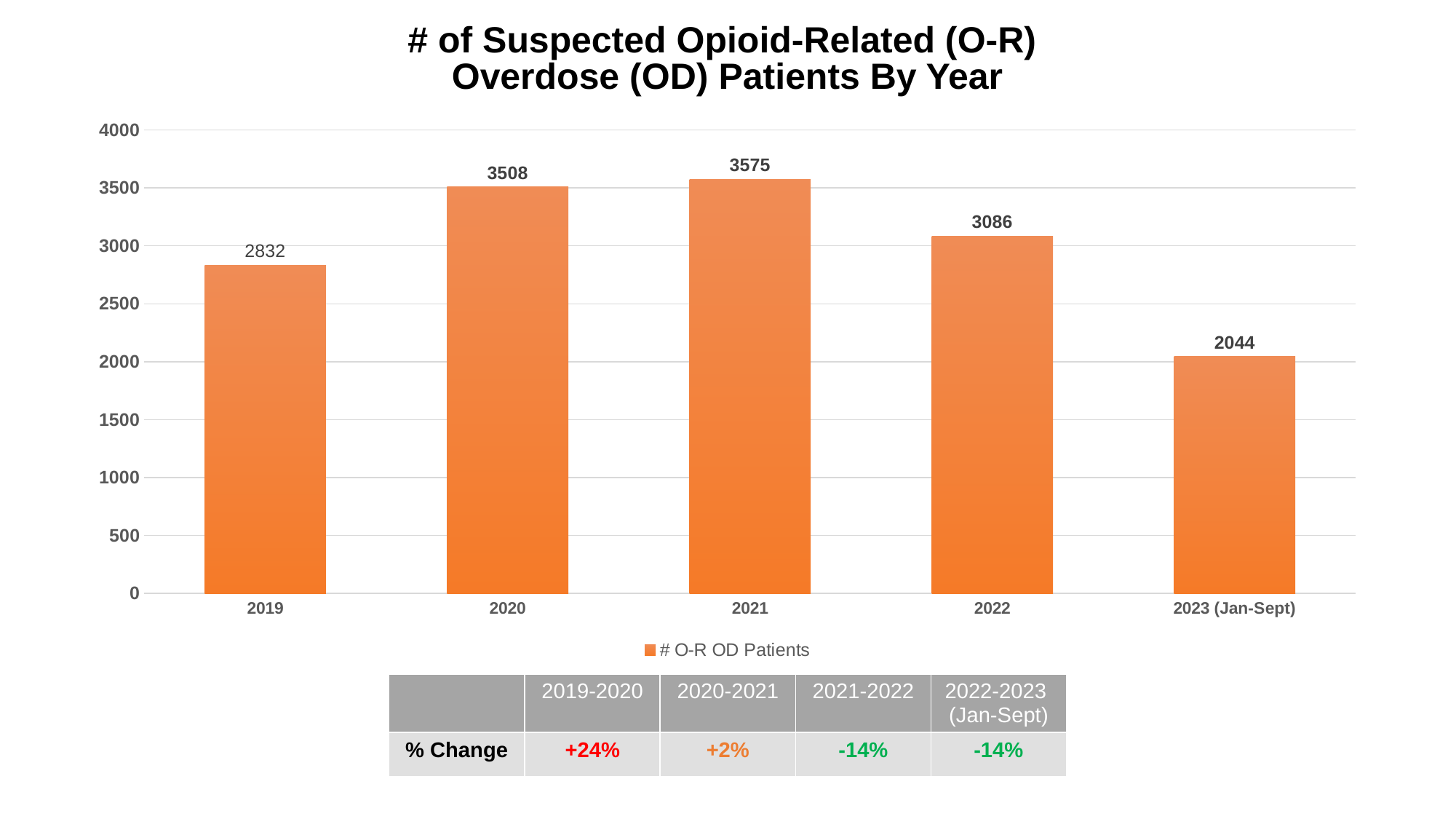
What is the legend entry for the series shown in the chart? # O-R OD Patients What is the number of suspected opioid-related overdose patients in 2021? 3575 Which year has the highest number of suspected opioid-related overdose patients? 2021 Which year had more suspected opioid-related overdose patients, 2019 or 2022? 2022 What is the difference between the number of patients in 2020 and in 2019? 676 What is the value shown for 2023 (Jan-Sept)? 2044 How many categories (years) are shown on the x axis? 5 Which category has the lowest number of suspected opioid-related overdose patients? 2023 (Jan-Sept) What is the number of suspected opioid-related overdose patients in 2019? 2832 What type of chart is shown on the slide? Bar chart What is the difference between the number of patients in 2021 and in 2022? 489 Is the value for 2022 greater or less than 3000? greater